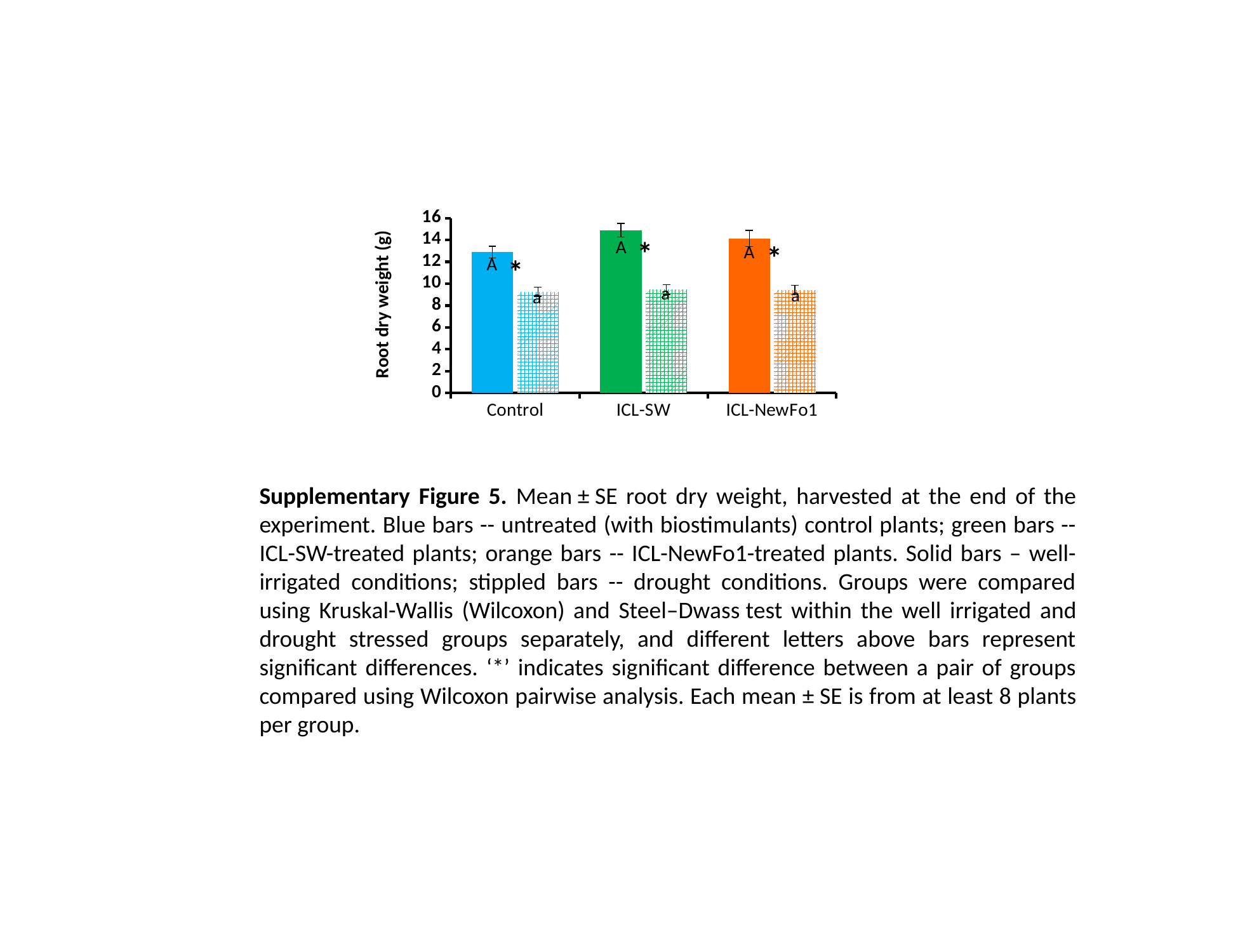
For ICL-SW, which bar is taller: the solid well-irrigated bar or the stippled drought bar? solid well-irrigated bar What colour are the bars for the ICL-NewFo1 treatment? orange Which is larger: the solid bar for ICL-SW or the solid bar for Control? ICL-SW Is the solid (well-irrigated) bar for Control greater or less than 12? greater Is the solid (well-irrigated) bar for ICL-SW greater or less than 14? greater What is the label of the vertical axis of the chart? Root dry weight (g) Is the stippled (drought) bar for Control greater or less than 10? less What kind of chart is shown on the slide? bar chart Among the solid (well-irrigated) bars, which treatment has the lowest root dry weight? Control How many treatment categories are shown on the x axis of the chart? 3